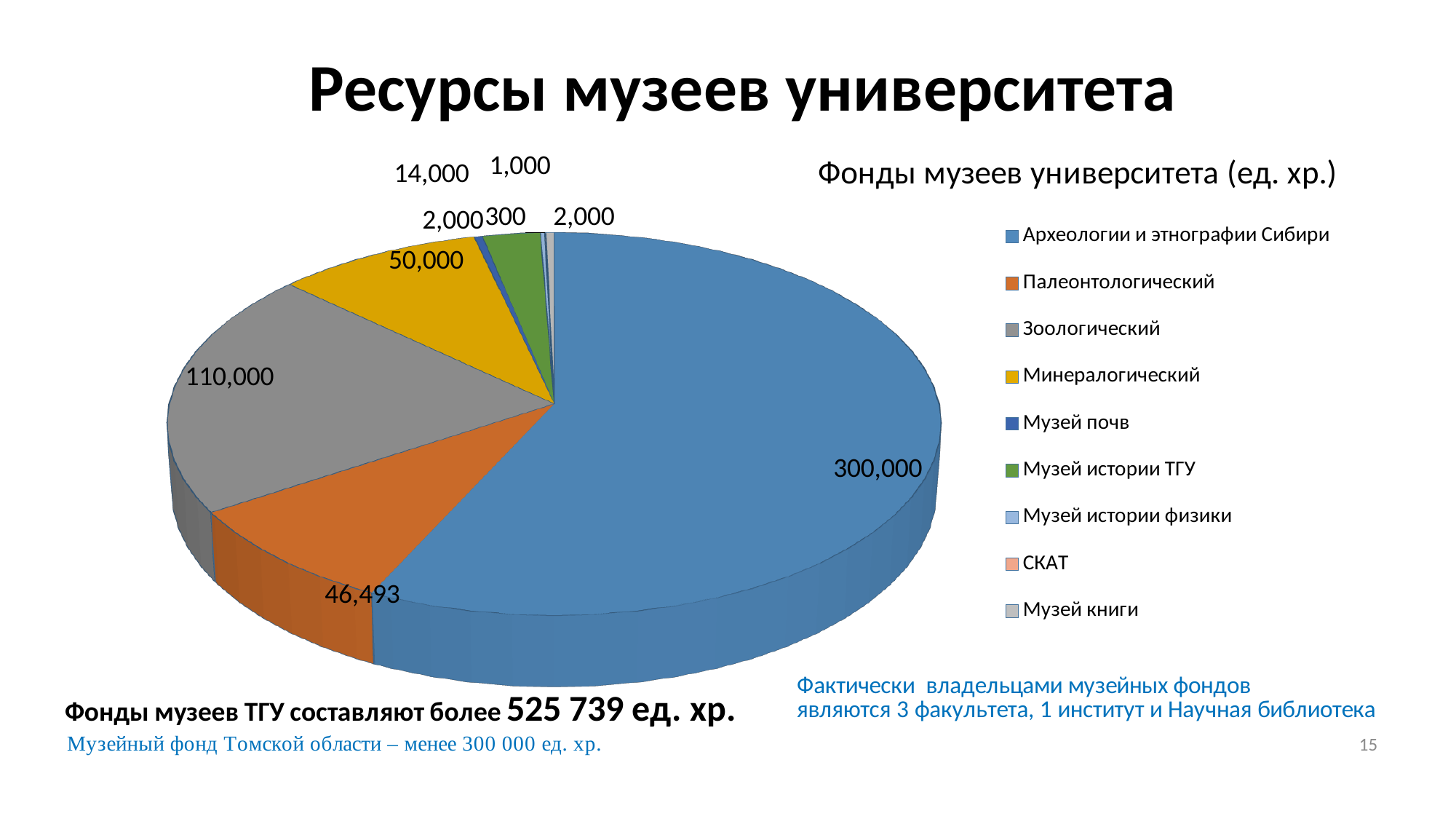
What is the smallest value labelled on the pie chart? 300 What is the value for Археологии и этнографии Сибири? 300,000 Which is larger, the value for Зоологический or for Минералогический? Зоологический What is the value for Палеонтологический? 46,493 Which museum has the largest share of the pie? Археологии и этнографии Сибири What is the difference between the values for Археологии и этнографии Сибири and Зоологический? 190,000 What is the value for Зоологический? 110,000 How many categories does the chart legend list? 9 What kind of chart is shown on the slide? Pie chart What is the value for Минералогический? 50,000 What is the title of the chart? Фонды музеев университета (ед. хр.) What is the value for Музей истории ТГУ? 14,000